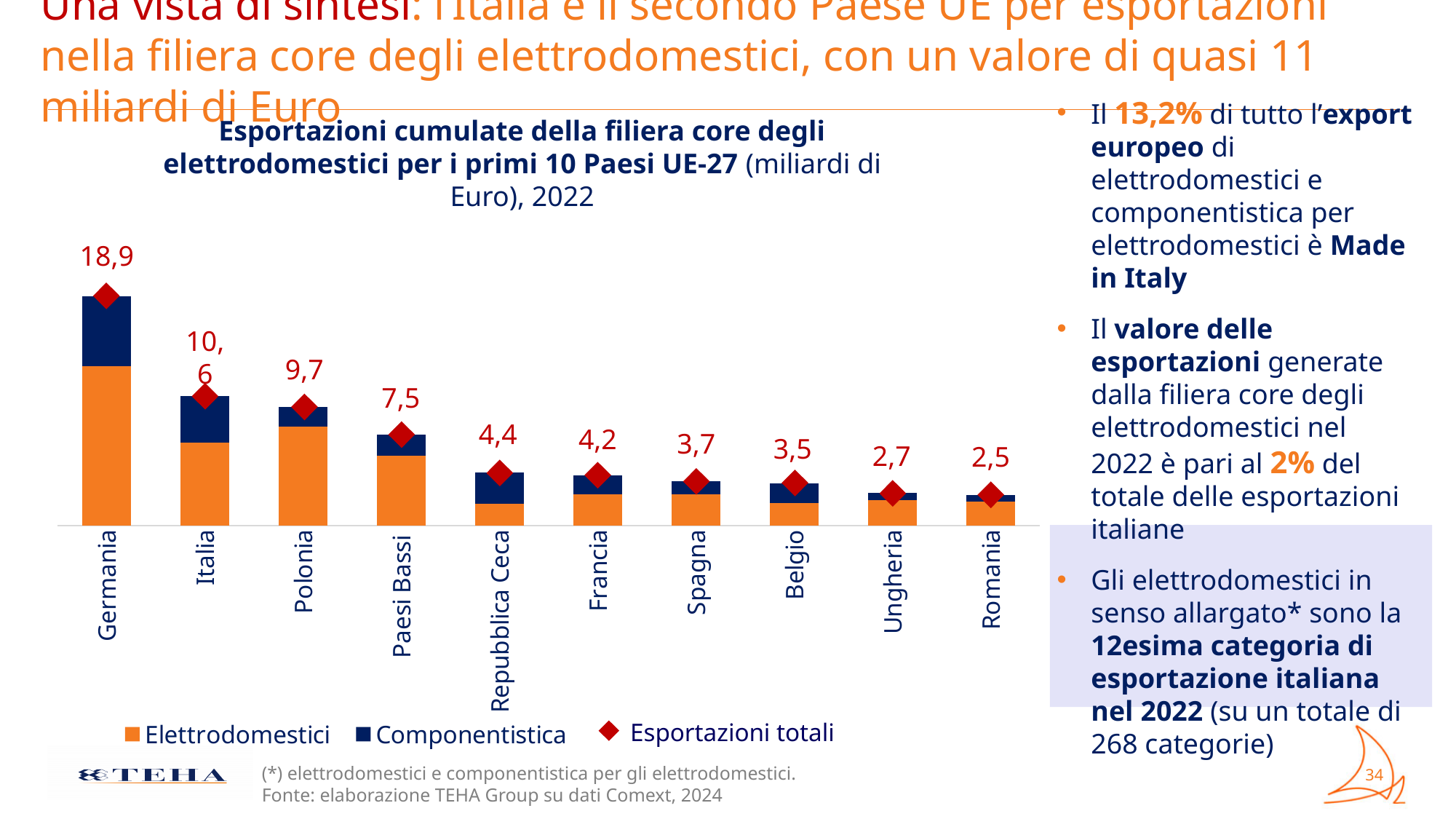
How many entries does the chart legend list? 3 Which country has the highest total exports in the chart? Germania What is the total export value shown for Germania? 18,9 What is the difference between the total exports of Polonia and Paesi Bassi? 2,2 Which has higher total exports, Spagna or Belgio? Spagna How many countries are shown in the chart? 10 What is the difference between the total exports of Germania and Italia? 8,3 Which country has the lowest total exports in the chart? Romania What is the total export value shown for Repubblica Ceca? 4,4 What kind of chart is shown on the slide? Stacked bar chart Do the total export values rise or fall from left to right across the countries? Fall What is the total export value shown for Italia? 10,6